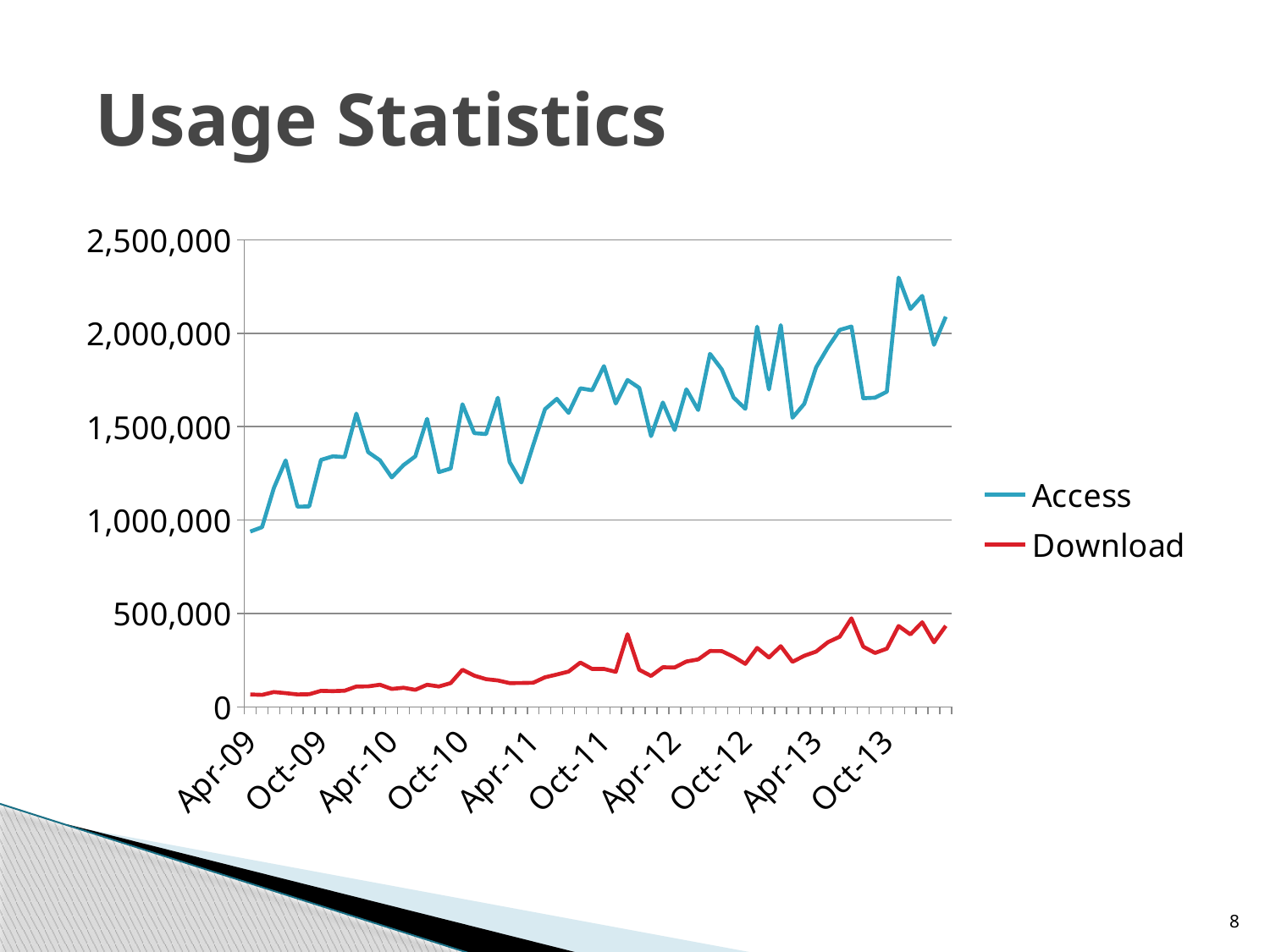
Is the highest value of the Access series greater or less than 2,000,000? greater What is the highest value shown on the vertical axis? 2,500,000 What are the two series named in the legend? Access and Download What is the title of the slide containing the chart? Usage Statistics Is the value for Access at Apr-09 greater or less than 1,000,000? less Which series has higher values throughout the chart, Access or Download? Access What kind of chart is shown on the slide? line chart How many series does the legend list? 2 Does the Access series generally rise or fall from Apr-09 to the end of the chart? rise Does the Download series generally rise or fall from Apr-09 to the end of the chart? rise